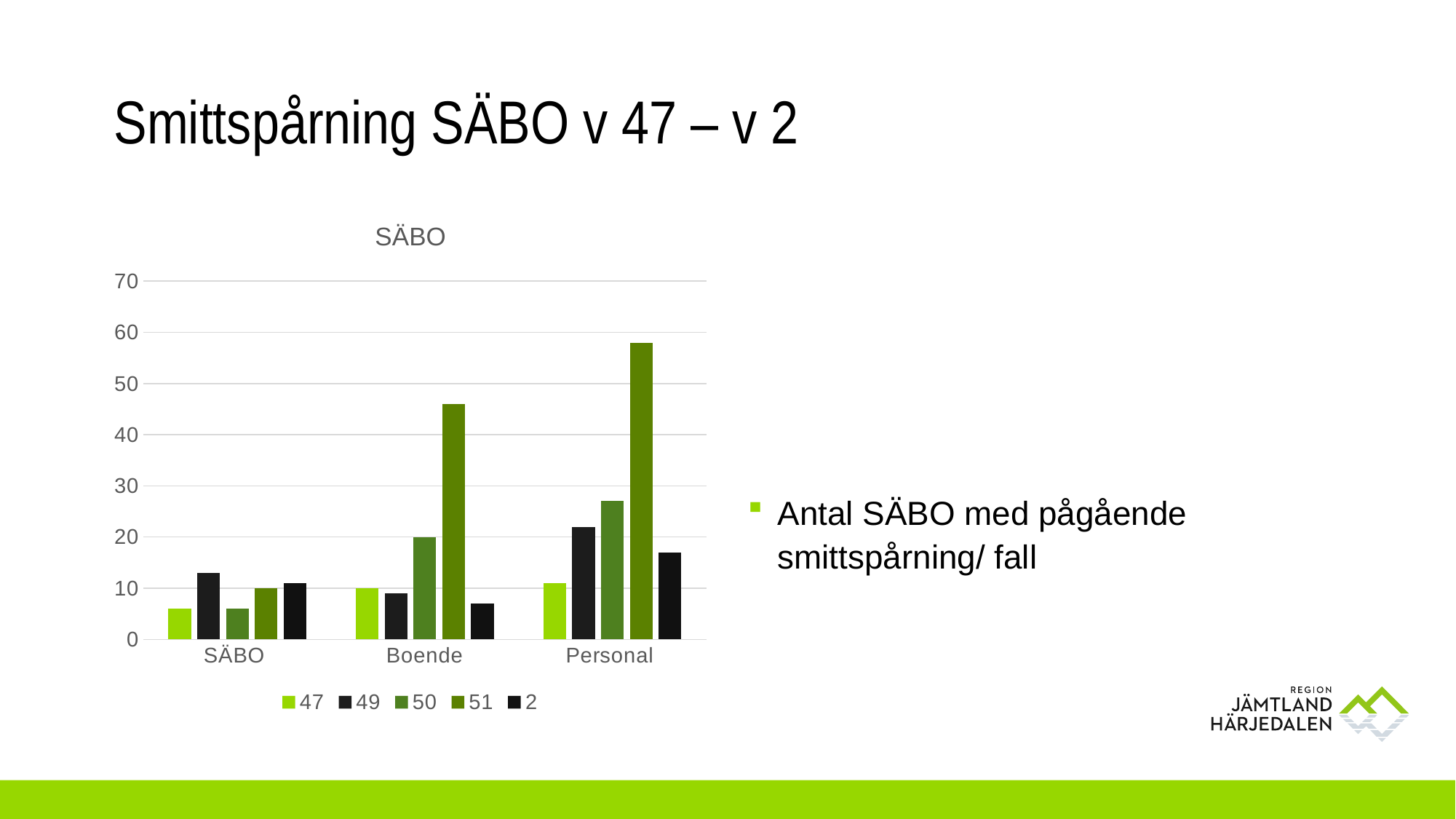
How many series does the legend of the chart list? 5 For series 51, which category has the highest value? Personal Do the values for series 51 rise or fall from SÄBO to Personal along the x axis? rise Which is larger: the value for Personal in series 50 or the value for Boende in series 50? Personal Is the value for Boende in series 51 greater or less than 40? greater Within the Personal category, which series has the lowest value? 47 Is the value for Personal in series 51 greater or less than 50? greater Is the value for SÄBO in series 47 greater or less than 10? less Within the Boende category, which is larger: series 49 or series 50? 50 What is the title of the chart? SÄBO What kind of chart is shown on the slide? bar chart How many categories are shown on the x axis of the chart? 3